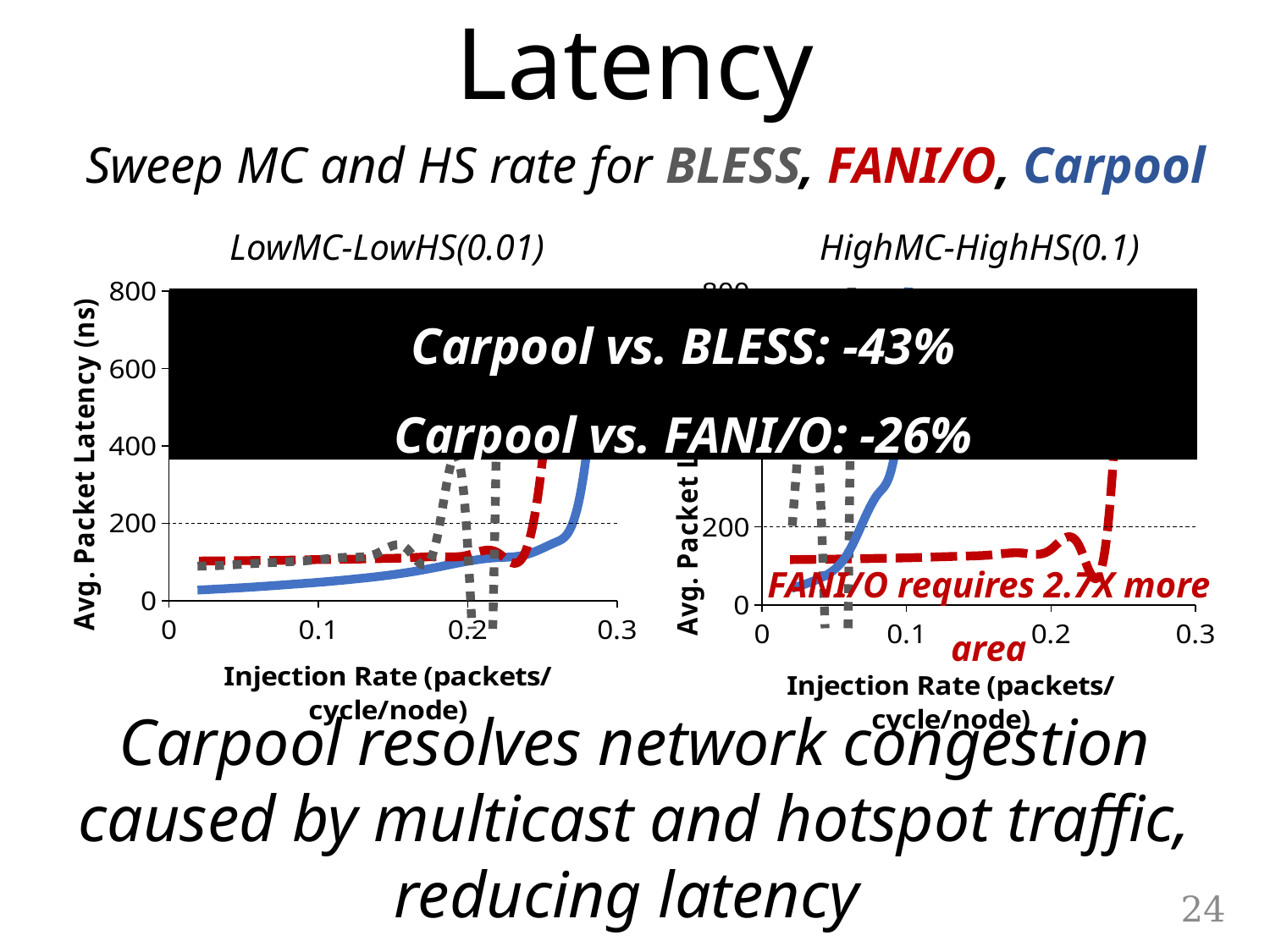
What is the x-axis label of the HighMC-HighHS(0.1) chart? Injection Rate (packets/cycle/node) In the HighMC-HighHS(0.1) chart, which series reaches the highest injection rate before its latency spikes, FANI/O or Carpool? FANI/O In the LowMC-LowHS(0.01) chart, which series reaches the highest injection rate before its latency spikes, BLESS or Carpool? Carpool In the HighMC-HighHS(0.1) chart, is the FANI/O latency at injection rate 0.2 greater or less than 200? less What is the y-axis label of the LowMC-LowHS(0.01) chart? Avg. Packet Latency (ns) How many series (BLESS, FANI/O, Carpool) are plotted in each chart? 3 How many charts are shown on the slide? 2 In the LowMC-LowHS(0.01) chart, is the Carpool latency at injection rate 0.1 greater or less than 200? less In the LowMC-LowHS(0.01) chart, does the Carpool latency rise or fall as the injection rate increases? rise In the LowMC-LowHS(0.01) chart, is the FANI/O latency at injection rate 0.1 greater or less than 200? less What is the maximum value shown on the x axis of the HighMC-HighHS(0.1) chart? 0.3 What kind of chart is the LowMC-LowHS(0.01) chart? line chart